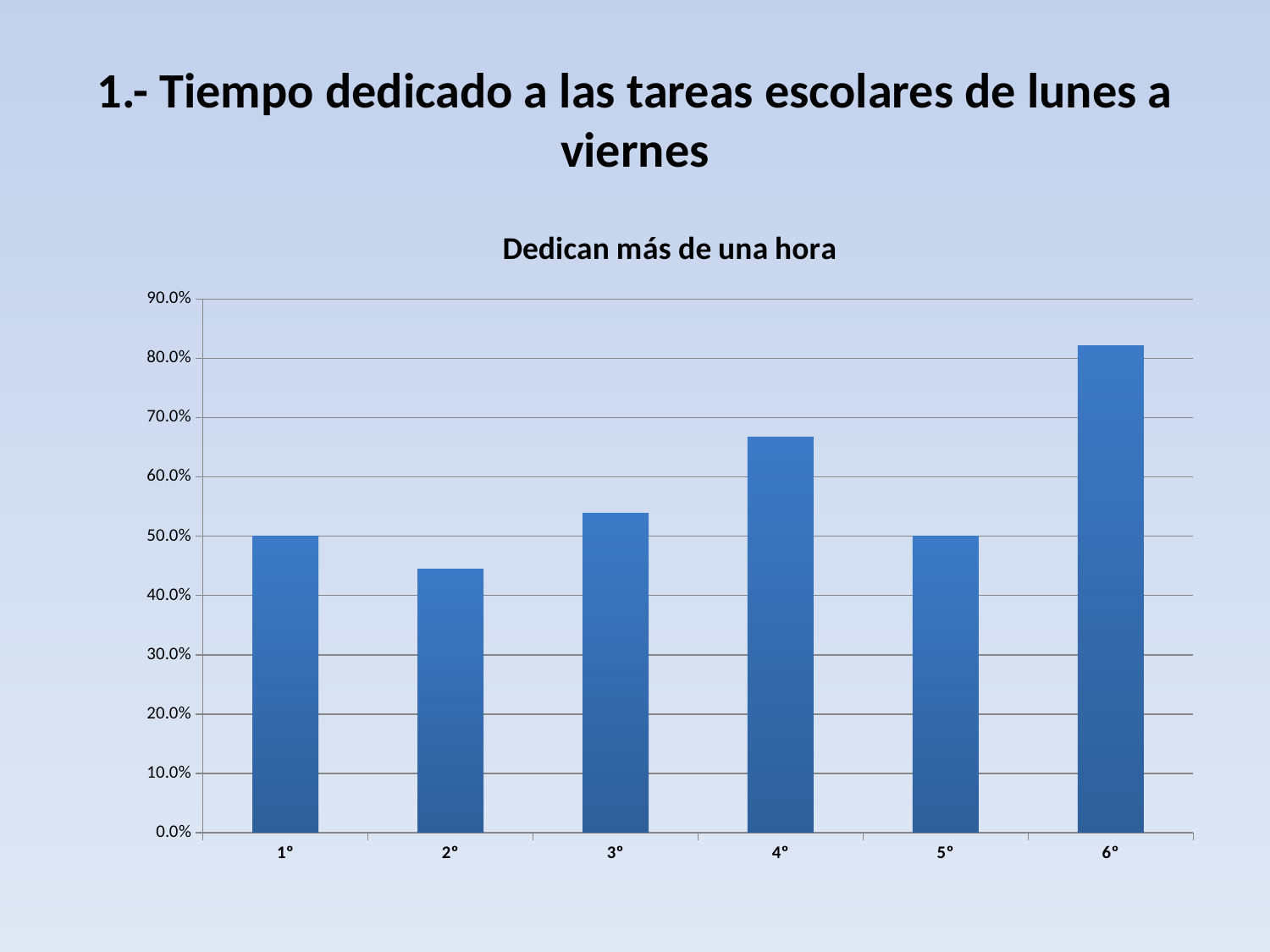
What is the title of the chart? Dedican más de una hora What type of chart is shown on the slide? bar chart Which category has the lowest value in the chart? 2° Is the value for 2° greater or less than 50.0%? less Is the value for 4° greater or less than 70.0%? less Is the value for 3° greater or less than 50.0%? greater Which has a larger value, 4° or 3°? 4° How many categories are shown on the x axis of the chart? 6 Does the value rise or fall from 4° to 5°? fall Which category has the highest value in the chart? 6° Which has a larger value, 6° or 4°? 6°